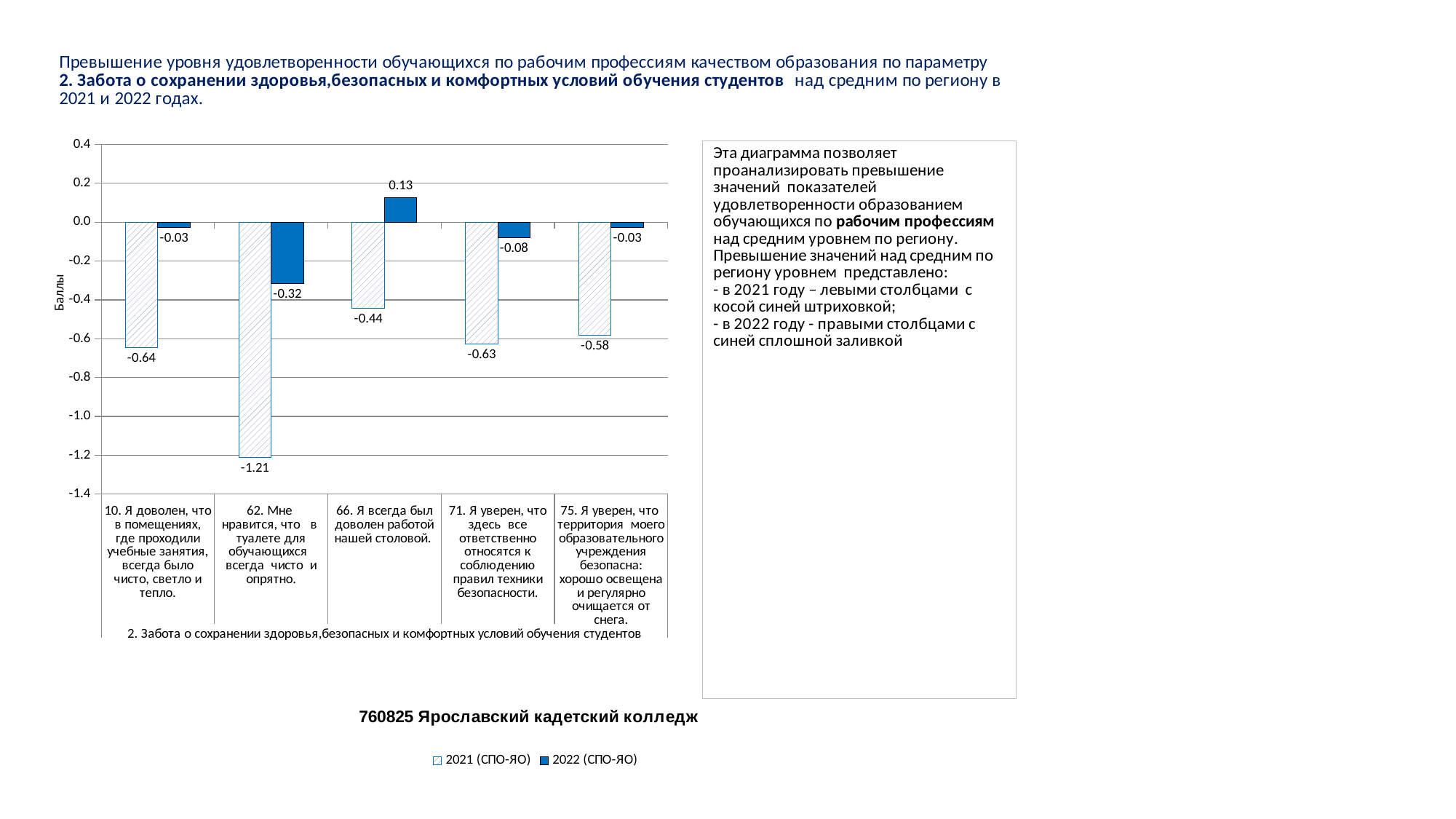
What is the 2021 (СПО-ЯО) value for item 62 (Мне нравится, что в туалете для обучающихся всегда чисто и опрятно)? -1.21 How many series does the chart legend list? 2 What is the 2021 (СПО-ЯО) value for item 75 (Я уверен, что территория моего образовательного учреждения безопасна)? -0.58 What is the difference between the 2022 and 2021 values for item 62? 0.89 What is the 2022 (СПО-ЯО) value for item 66 (Я всегда был доволен работой нашей столовой)? 0.13 What is the 2022 (СПО-ЯО) value for item 71 (Я уверен, что здесь все ответственно относятся к соблюдению правил техники безопасности)? -0.08 Which item has the lowest 2021 (СПО-ЯО) value? 62. Мне нравится, что в туалете для обучающихся всегда чисто и опрятно. What is the label of the vertical axis of the chart? Баллы What type of chart is shown on the slide? Bar chart How many items (categories) are shown on the x axis of the chart? 5 Which item has the highest 2022 (СПО-ЯО) value? 66. Я всегда был доволен работой нашей столовой. Which is larger for item 10: the 2021 (СПО-ЯО) value or the 2022 (СПО-ЯО) value? 2022 (СПО-ЯО)